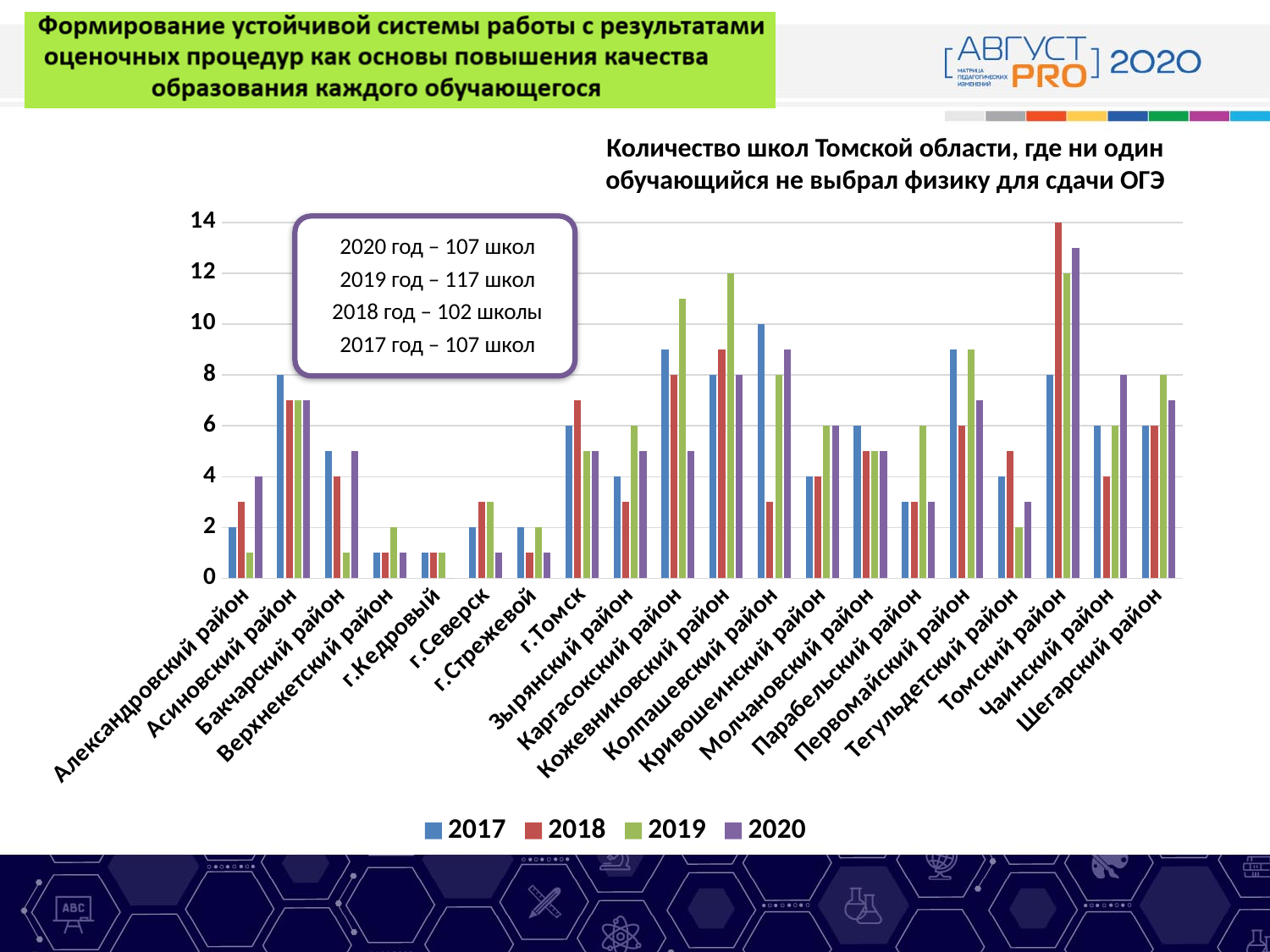
What is the value for Кожевниковский район in 2019? 12 What kind of chart is shown on the slide? bar chart What is the difference between the 2018 and 2017 values for Томский район? 6 According to the text box, how many schools were there in 2018? 102 школы Is the value for Каргасокский район in 2019 greater or less than 10? greater What is the value for Колпашевский район in 2017? 10 How many districts (categories) are shown on the x axis? 20 Which is larger for Томский район: the 2018 value or the 2017 value? 2018 Which district has the highest value for 2018? Томский район What is the value for Томский район in 2018? 14 How many series does the legend list? 4 According to the text box, how many schools were there in 2019? 117 школ